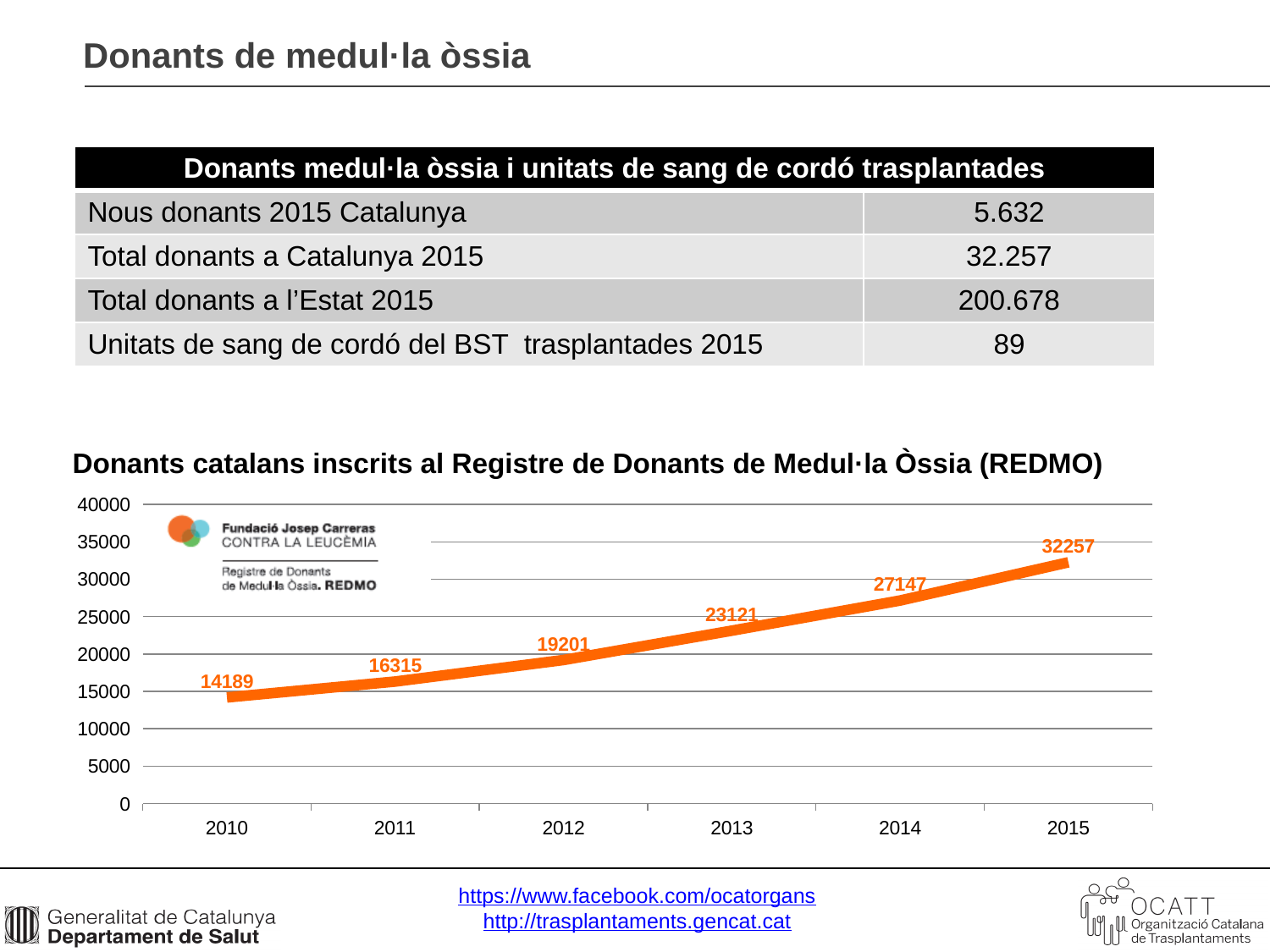
What is the value for 2015 in the chart? 32257 Which year has the highest value in the chart? 2015 Is the value for 2014 greater or less than 25000? greater Which is larger, the value for 2014 or the value for 2013? 2014 What is the difference between the values for 2015 and 2010? 18068 What is the value for 2010 in the chart? 14189 Which year has the lowest value in the chart? 2010 What kind of chart is shown on the slide? line chart What is the difference between the values for 2012 and 2011? 2886 How many years are plotted in the chart? 6 Do the values rise or fall from 2010 to 2015? rise What is the value for 2013 in the chart? 23121